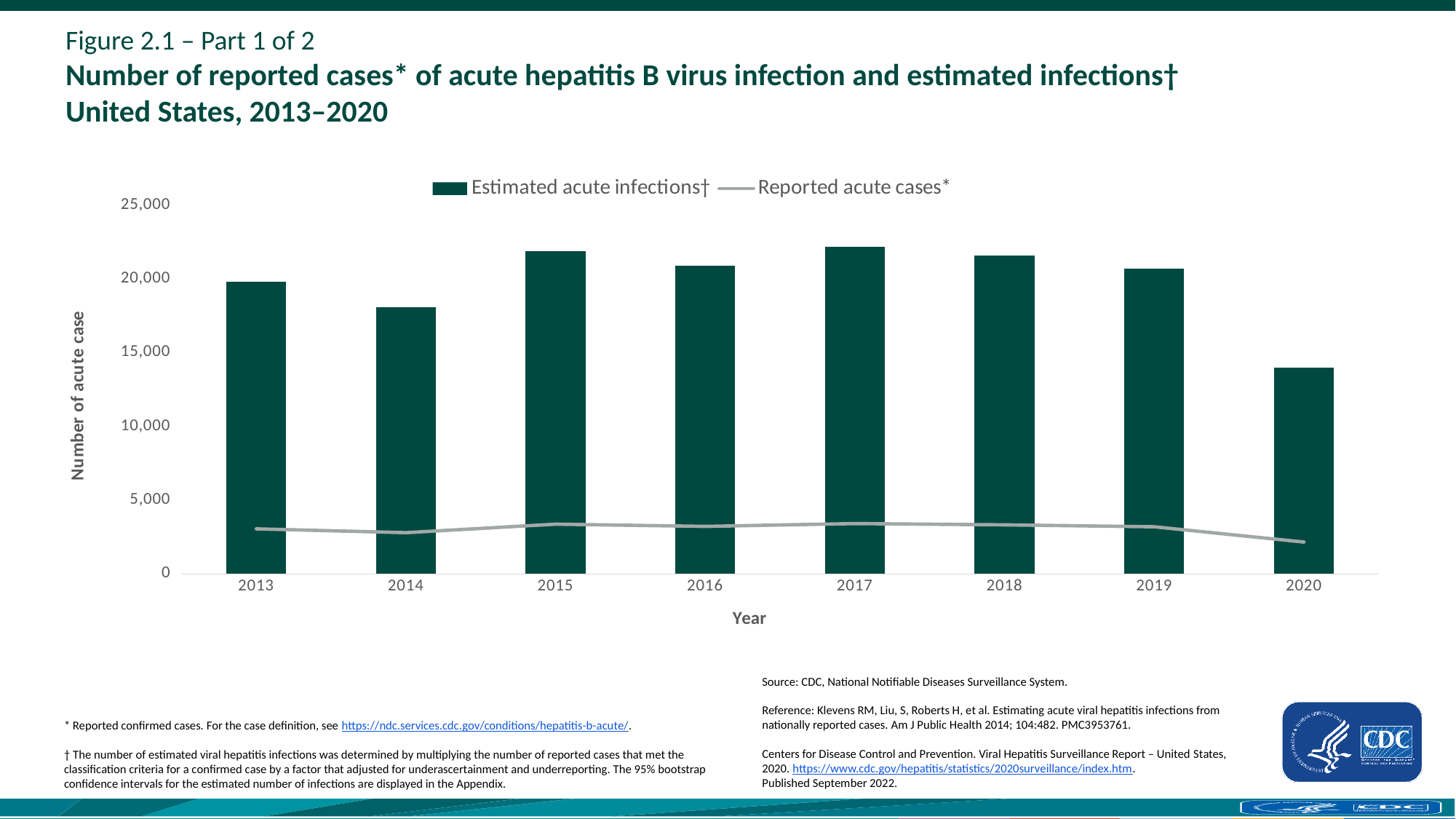
Which year has more estimated acute infections, 2013 or 2020? 2013 Is the value for estimated acute infections in 2020 greater or less than 15,000? less Do estimated acute infections rise or fall from 2019 to 2020? fall Which year has the lowest estimated acute infections? 2020 What kind of chart is shown on the slide? A bar chart with a line series How many series does the chart legend list? 2 Which year has more estimated acute infections, 2014 or 2015? 2015 Is the value for estimated acute infections in 2017 greater or less than 20,000? greater How many years are shown on the x axis of the chart? 8 What is the title of the vertical axis of the chart? Number of acute case Is the value for estimated acute infections in 2014 greater or less than 20,000? less